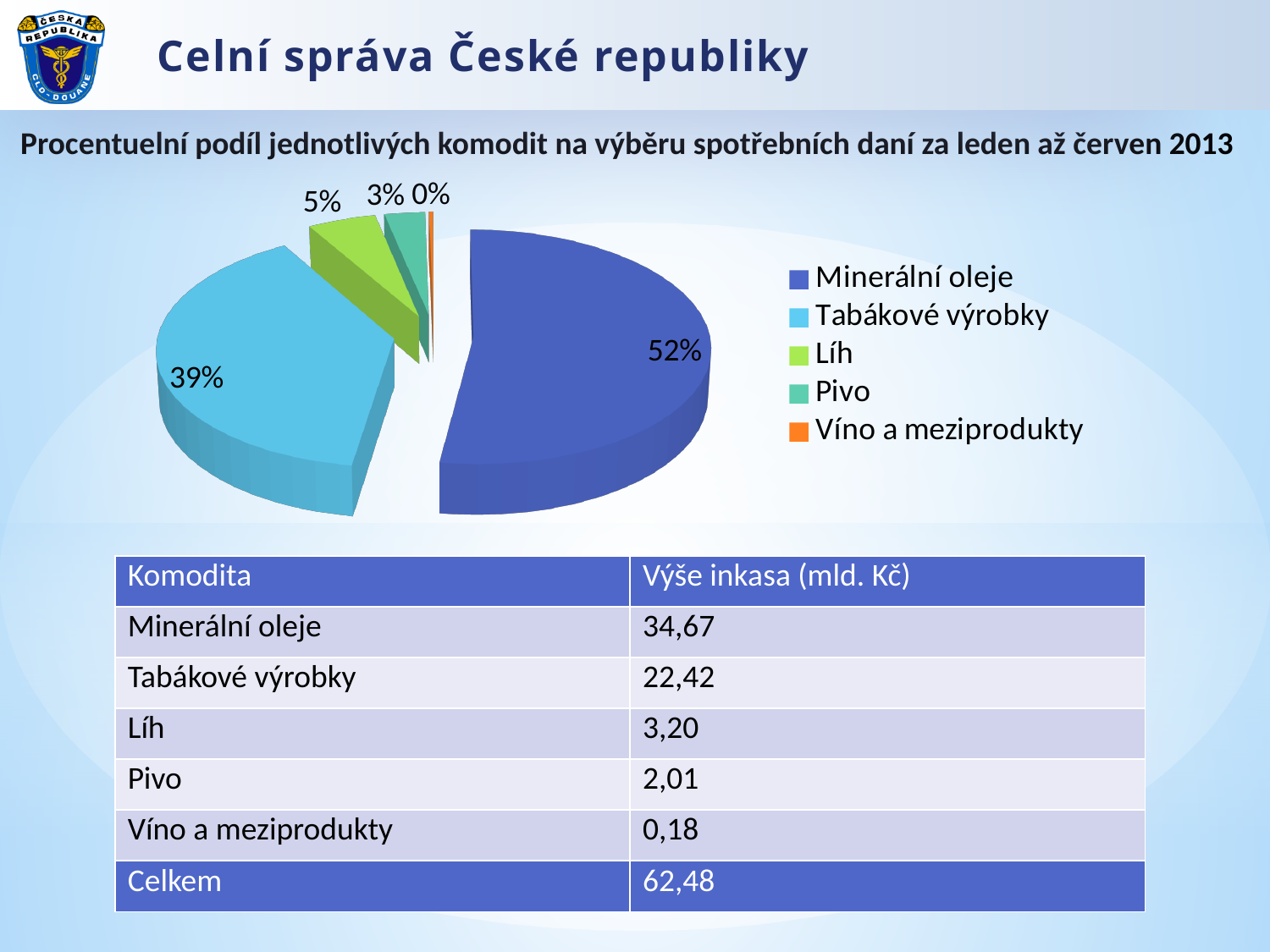
What percentage share does Tabákové výrobky have in the pie chart? 39% What percentage share does Víno a meziprodukty have in the pie chart? 0% What percentage share does Pivo have in the pie chart? 3% What is the difference in percentage points between the shares of Minerální oleje and Tabákové výrobky? 13 Which commodity has the smallest share in the pie chart? Víno a meziprodukty Which has a larger share in the pie chart, Líh or Pivo? Líh Which commodity has the largest share in the pie chart? Minerální oleje How many entries does the legend of the pie chart list? 5 What type of chart is shown on the slide? pie chart What percentage share does Minerální oleje have in the pie chart? 52% What percentage share does Líh have in the pie chart? 5% What colour is the Tabákové výrobky slice in the pie chart? light blue